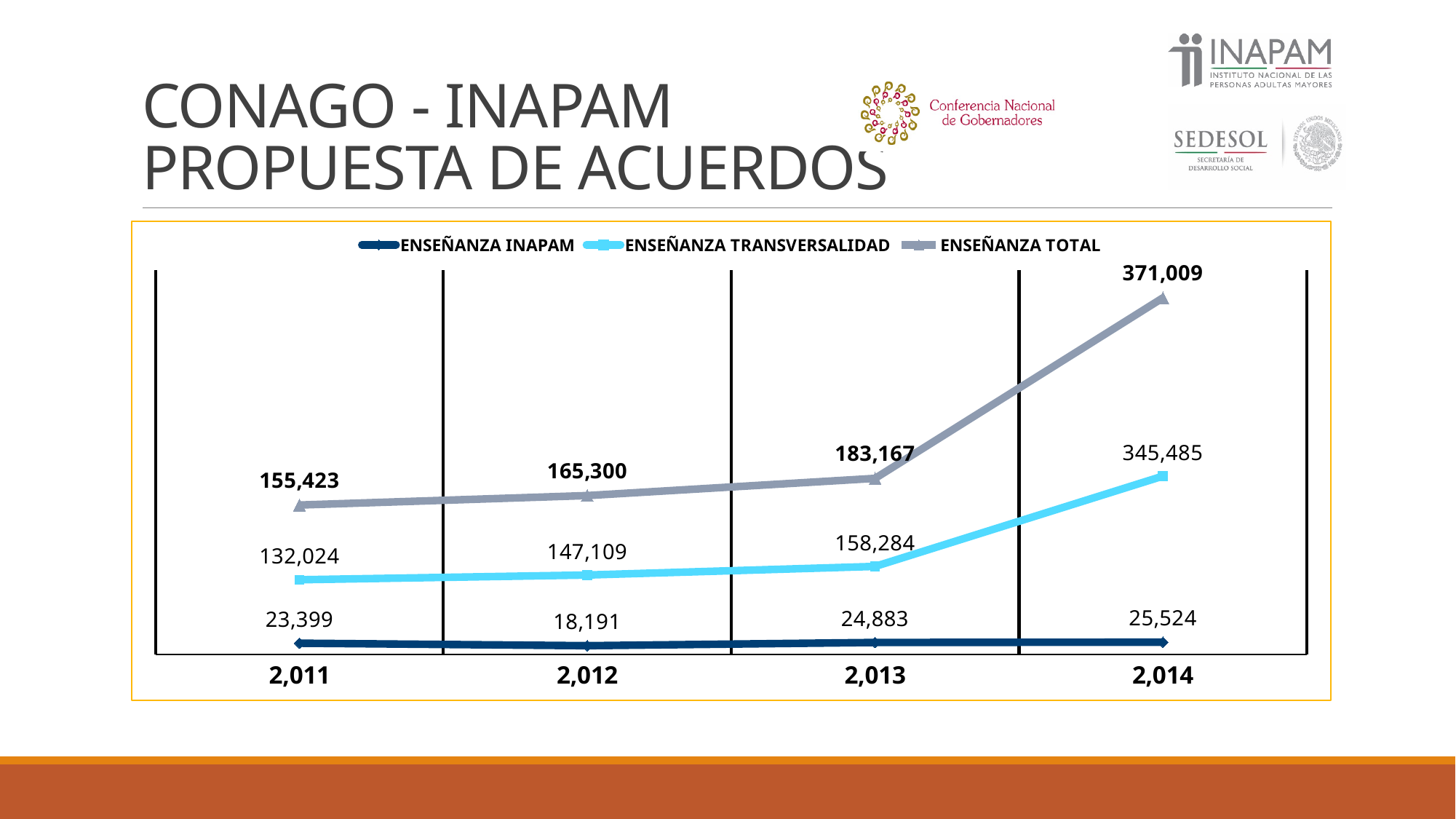
Which is larger in 2,011: ENSEÑANZA TRANSVERSALIDAD or ENSEÑANZA INAPAM? ENSEÑANZA TRANSVERSALIDAD What kind of chart is shown on the slide? line chart In which year is ENSEÑANZA INAPAM lowest? 2,012 Does ENSEÑANZA TRANSVERSALIDAD rise or fall from 2,011 to 2,014? rise What is the difference between ENSEÑANZA TOTAL in 2,014 and in 2,013? 187,842 Which series is drawn in grey? ENSEÑANZA TOTAL How many series does the legend list? 3 What is the value of ENSEÑANZA TOTAL in 2,014? 371,009 In which year is ENSEÑANZA TOTAL highest? 2,014 What is the value of ENSEÑANZA INAPAM in 2,013? 24,883 What is the value of ENSEÑANZA TRANSVERSALIDAD in 2,012? 147,109 How many years are shown on the x axis? 4